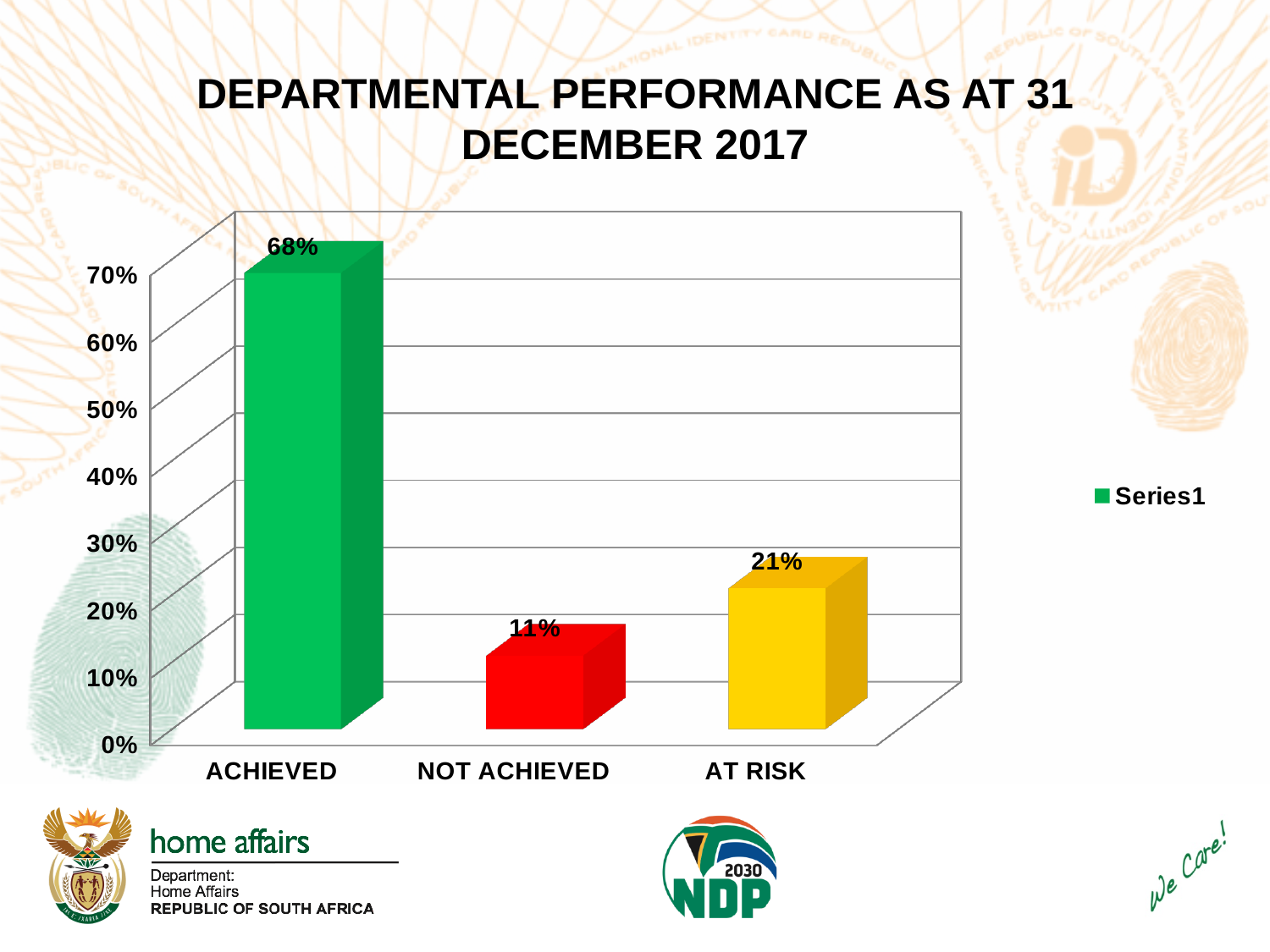
Which is larger, the value for AT RISK or the value for NOT ACHIEVED? AT RISK What is the value for AT RISK? 21% What is the value for ACHIEVED? 68% Which category has the lowest value? NOT ACHIEVED What kind of chart is shown on the slide? bar chart What is the difference between the values for AT RISK and NOT ACHIEVED? 10% Which category has the highest value? ACHIEVED What is the difference between the values for ACHIEVED and AT RISK? 47% How many categories are shown on the x axis? 3 What is the title of the chart? DEPARTMENTAL PERFORMANCE AS AT 31 DECEMBER 2017 Is the value for ACHIEVED greater or less than 60%? greater What is the value for NOT ACHIEVED? 11%